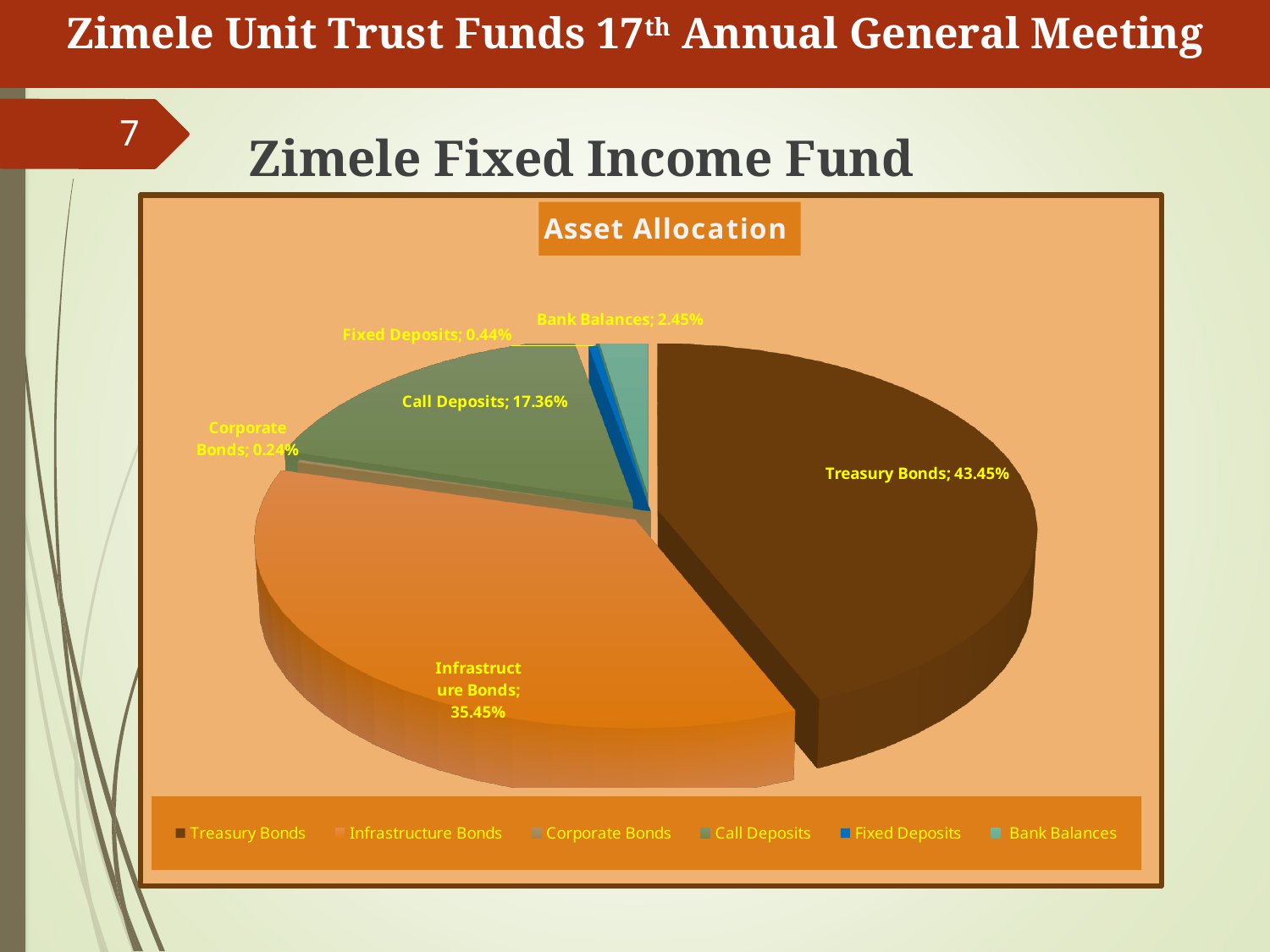
What is the difference between the Treasury Bonds and Infrastructure Bonds shares in the Asset Allocation chart? 8.00% What is the value shown for Fixed Deposits in the Asset Allocation chart? 0.44% How many categories are shown in the Asset Allocation chart? 6 What type of chart is used to show the Asset Allocation? Pie chart Which is larger in the Asset Allocation chart, Call Deposits or Bank Balances? Call Deposits What is the value shown for Call Deposits in the Asset Allocation chart? 17.36% What share of the Asset Allocation pie is Treasury Bonds? 43.45% What is the title of the chart on the slide? Asset Allocation What share of the Asset Allocation pie is Infrastructure Bonds? 35.45% Which category has the smallest slice in the Asset Allocation chart? Corporate Bonds What is the value shown for Bank Balances in the Asset Allocation chart? 2.45% Which category has the largest slice in the Asset Allocation chart? Treasury Bonds